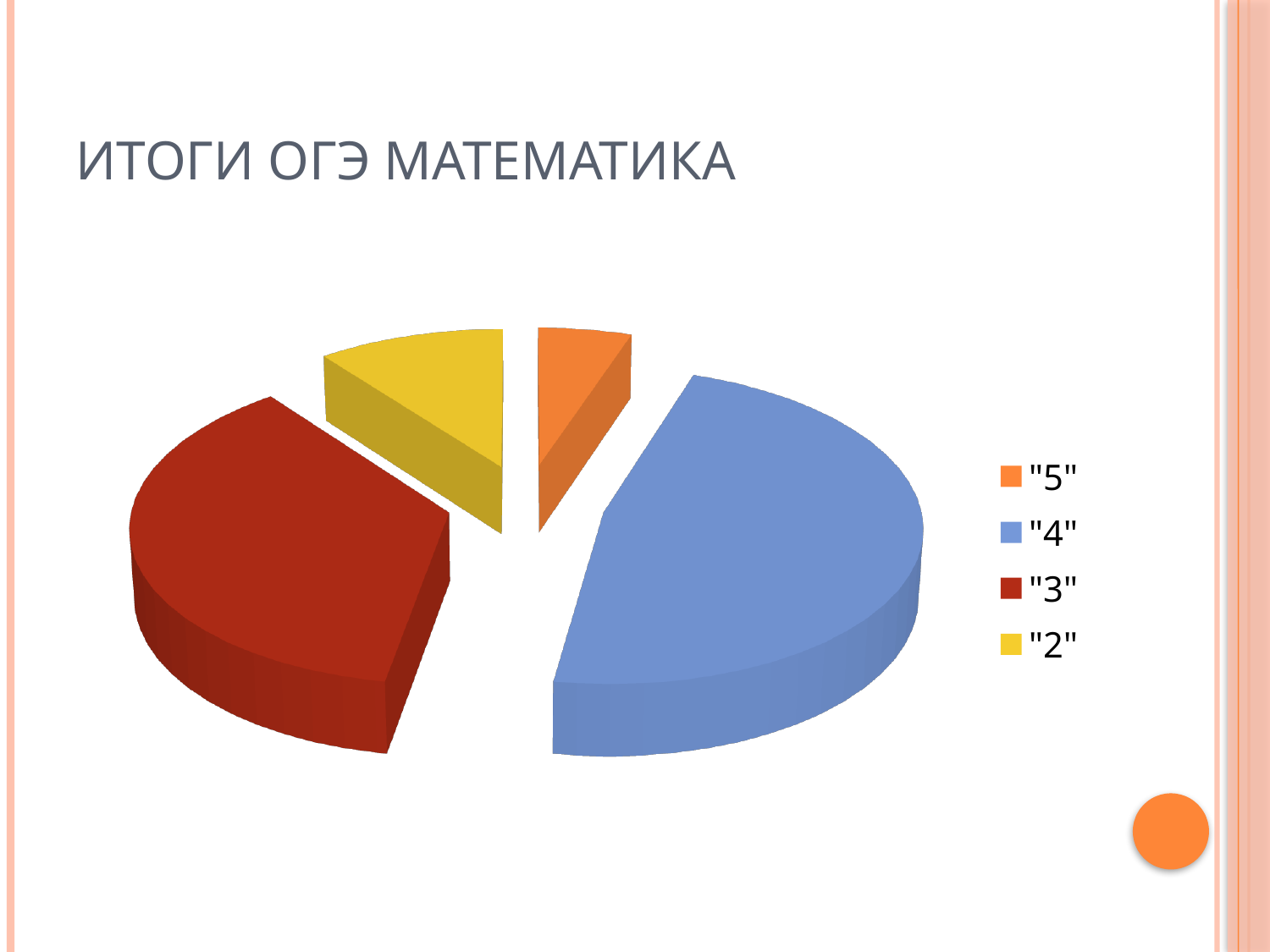
What colour is the slice for "3" in the pie chart? red What is the title of the slide containing the pie chart? ИТОГИ ОГЭ МАТЕМАТИКА How many categories does the legend of the pie chart list? 4 Which category has the smallest slice in the pie chart? "5" What kind of chart is shown on the slide? pie chart Which slice is larger, "4" or "3"? "4" Which slice is larger, "3" or "2"? "3" Which category has the largest slice in the pie chart? "4" Which slice is larger, "2" or "5"? "2"